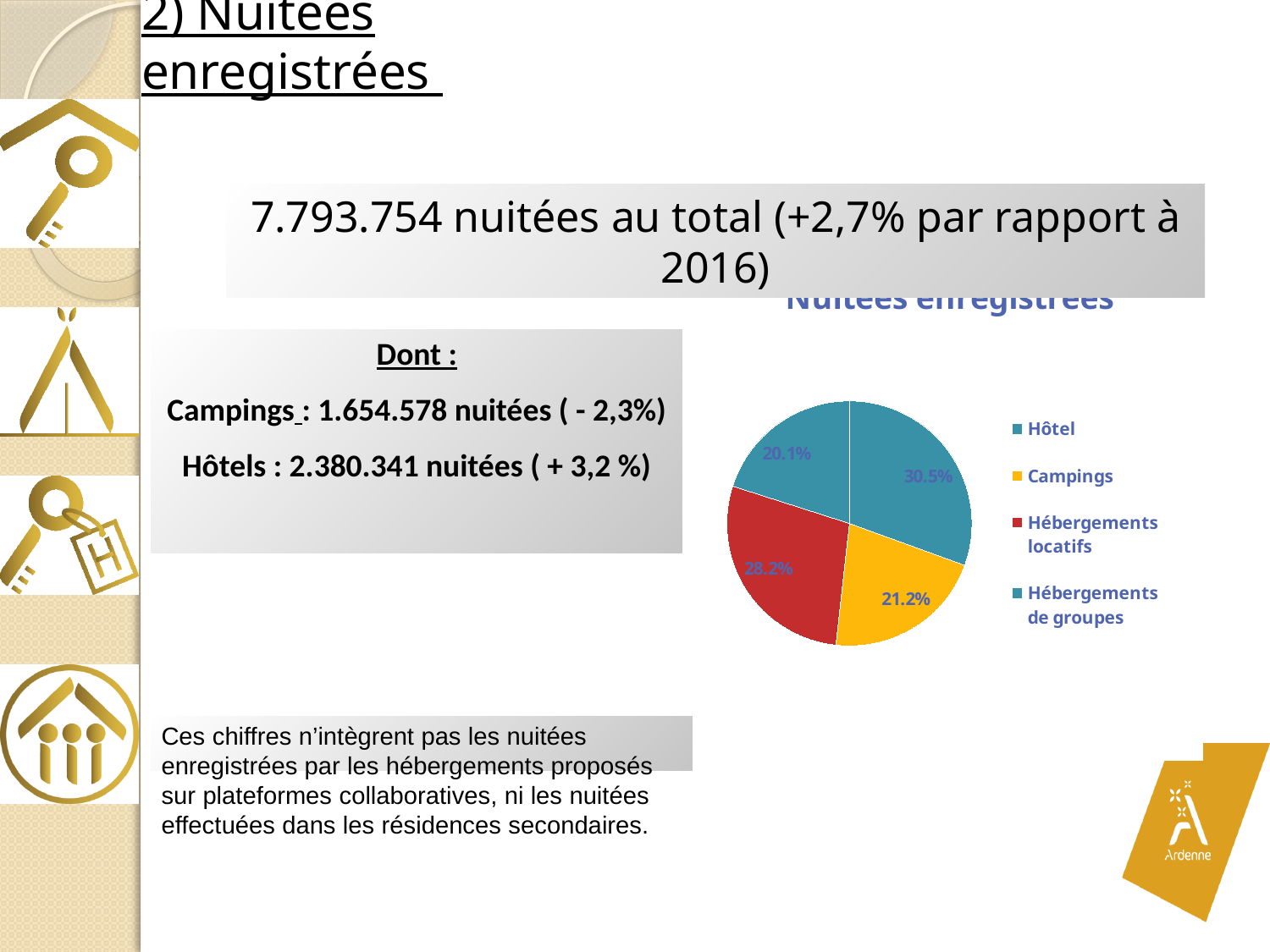
What type of chart is shown on the slide? pie chart What share of the pie chart does Hébergements de groupes represent? 20.1% What share of the pie chart does Hôtel represent? 30.5% Which category has the smallest slice of the pie chart? Hébergements de groupes What share of the pie chart does Hébergements locatifs represent? 28.2% How many slices does the pie chart have? 4 What is the difference in percentage points between the Hôtel slice and the Campings slice? 9.3 Which category has the largest slice of the pie chart? Hôtel How many entries does the legend of the pie chart list? 4 What share of the pie chart does Campings represent? 21.2% Which slice is larger: Hébergements locatifs or Campings? Hébergements locatifs What colour is the Campings slice in the pie chart? yellow